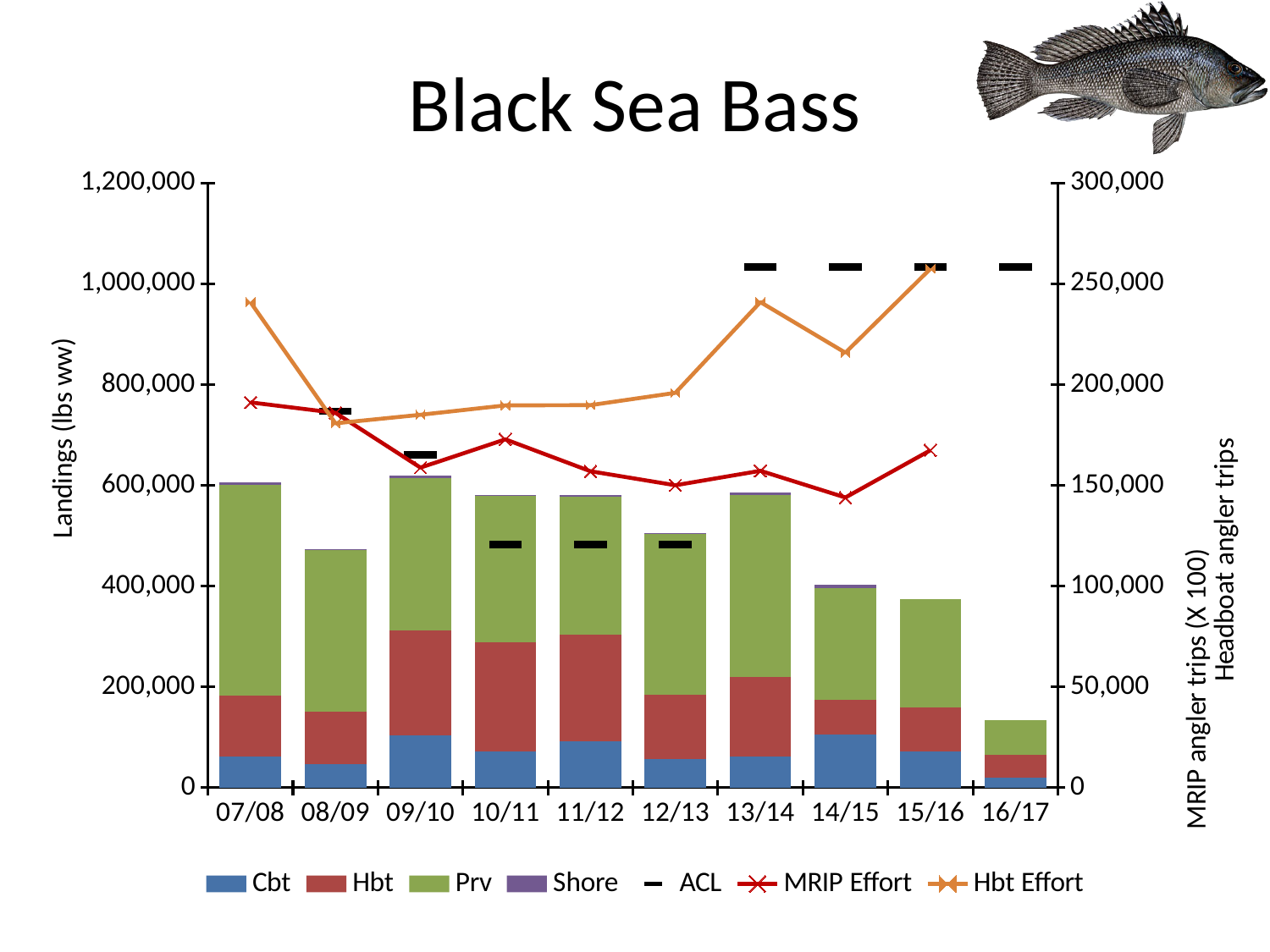
What kind of chart is shown on the slide? A combination chart with stacked bars and lines Is the total landings value for 16/17 greater or less than 200,000? less Which is larger in 13/14, Hbt Effort or MRIP Effort? Hbt Effort In which fishing year is Hbt Effort highest? 15/16 Is the Hbt Effort value for 07/08 greater or less than 200,000? greater What is the title of the chart? Black Sea Bass Do total landings rise or fall from 13/14 to 16/17? fall How many entries does the legend list? 7 How many fishing years are shown on the x axis? 10 Is the ACL value for 13/14 greater or less than 1,000,000? greater Which fishing year has the lowest total landings? 16/17 In which fishing year is MRIP Effort highest? 07/08